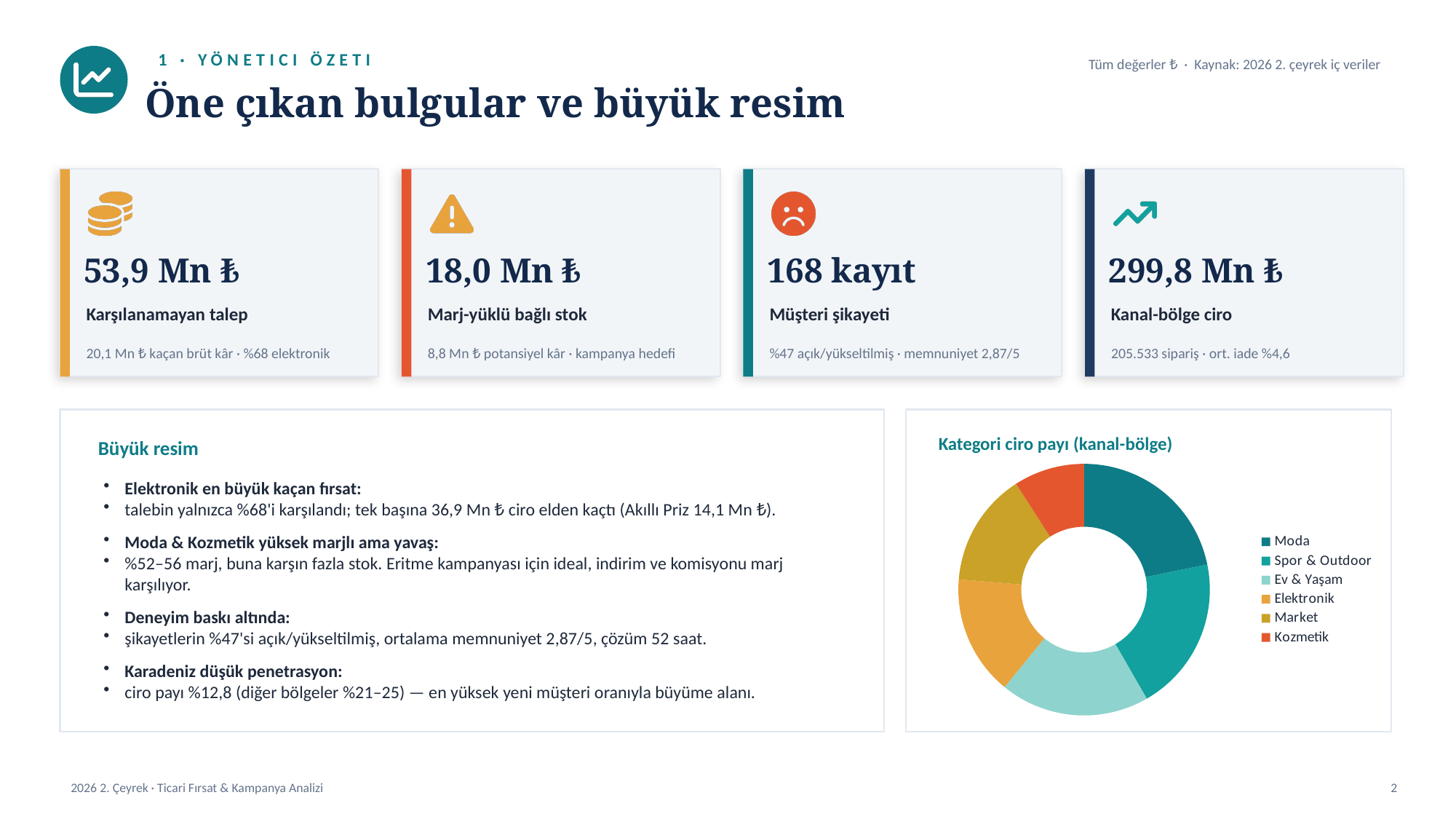
How many categories does the "Kategori ciro payı (kanal-bölge)" chart show? 6 In the "Kategori ciro payı (kanal-bölge)" chart, which slice is larger: Elektronik or Kozmetik? Elektronik In the "Kategori ciro payı (kanal-bölge)" chart, which category is shown in the red-orange colour? Kozmetik How many entries does the legend of the "Kategori ciro payı (kanal-bölge)" chart list? 6 In the "Kategori ciro payı (kanal-bölge)" chart, which category has the smallest slice? Kozmetik In the "Kategori ciro payı (kanal-bölge)" chart, which slice is larger: Spor & Outdoor or Market? Spor & Outdoor What kind of chart is shown under the title "Kategori ciro payı (kanal-bölge)"? Pie chart (donut) In the "Kategori ciro payı (kanal-bölge)" chart, which slice is larger: Moda or Kozmetik? Moda What is the title of the chart on the right side of the slide? Kategori ciro payı (kanal-bölge)